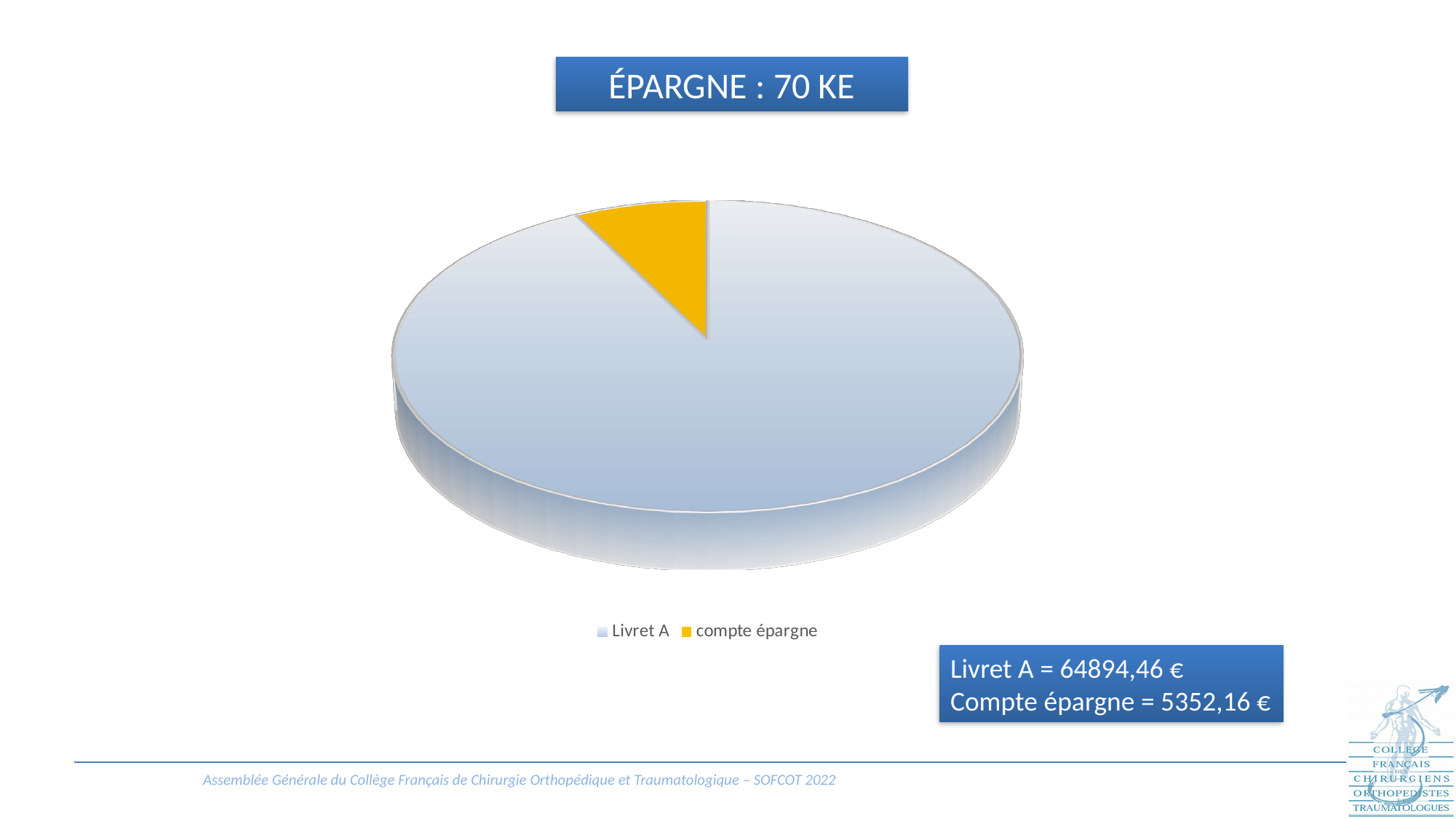
Which is larger, Livret A or Compte épargne? Livret A What is the difference between the Livret A value and the Compte épargne value? 59542,30 € What kind of chart is shown on the slide? Pie chart What is the value given for Compte épargne? 5352,16 € What is the value given for Livret A? 64894,46 € What is the title shown above the pie chart? ÉPARGNE : 70 KE Which category has the largest slice of the pie chart? Livret A How many entries does the legend of the pie chart list? 2 What colour is the compte épargne slice of the pie chart? Yellow How many slices does the pie chart have? 2 What is the total of the Livret A and Compte épargne values? 70246,62 € Which category has the smallest slice of the pie chart? compte épargne